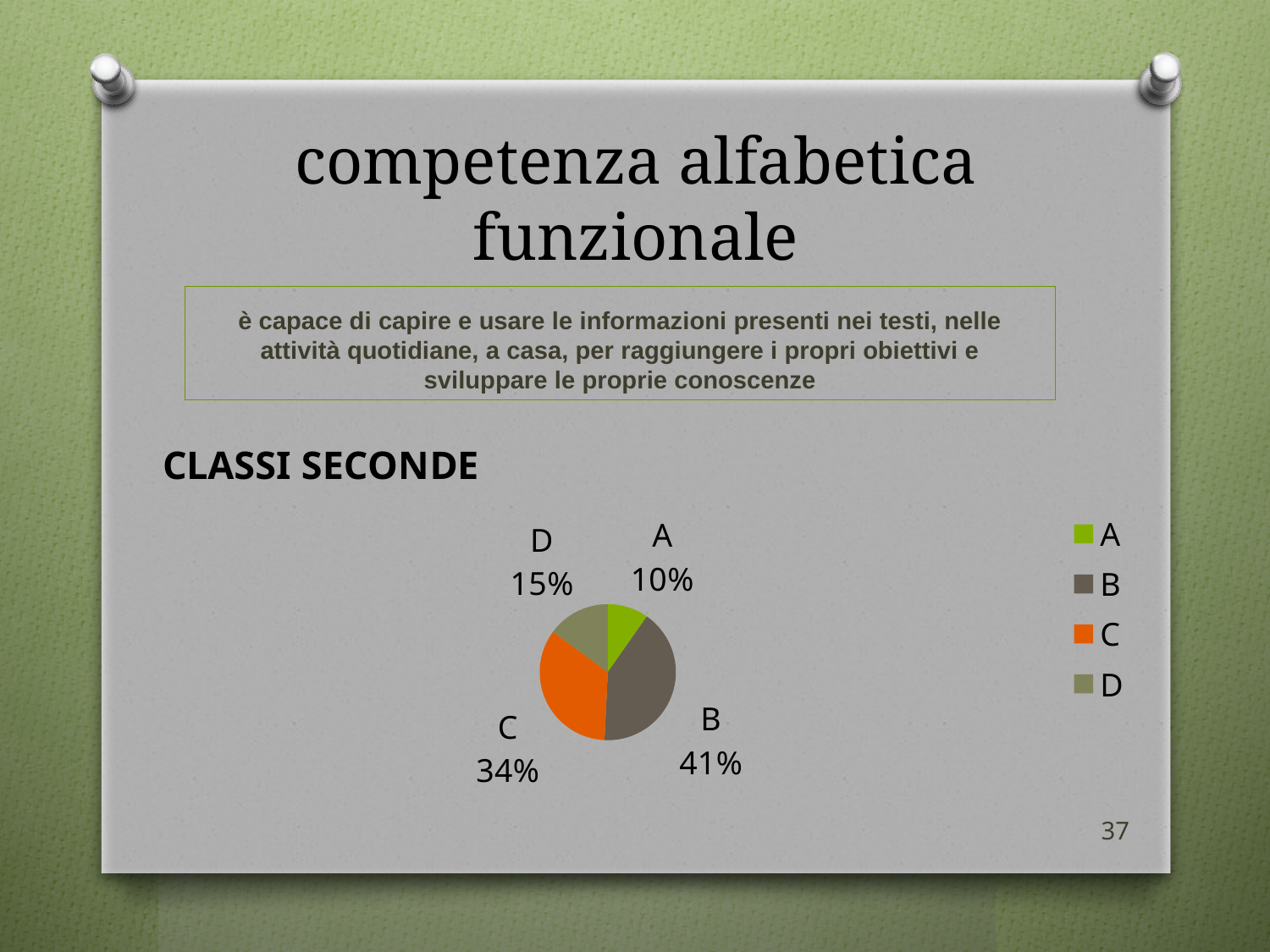
How many entries does the legend list? 4 What percentage does slice A represent in the pie chart? 10% What percentage does slice D represent in the pie chart? 15% Which is larger, the share for D or the share for A? D What kind of chart is shown on the slide? pie chart What percentage does slice B represent in the pie chart? 41% What percentage does slice C represent in the pie chart? 34% Which category has the smallest share of the pie chart? A How many slices does the pie chart have? 4 Which category has the largest share of the pie chart? B What is the difference in percentage points between slice B and slice C? 7 What colour is the slice for category C in the pie chart? orange